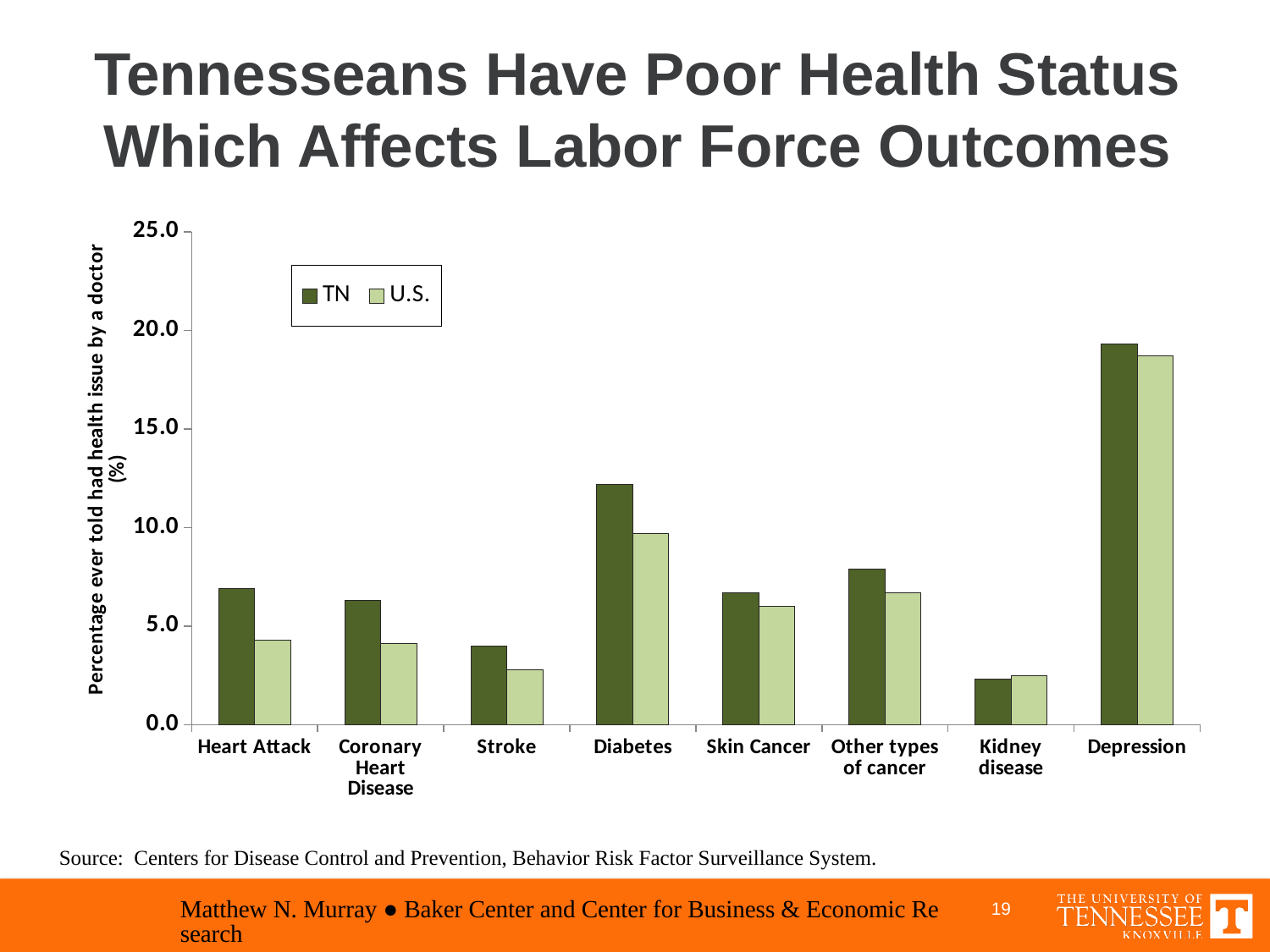
Is the U.S. value for Depression greater or less than 15.0? greater Is the TN value for Diabetes greater or less than 10.0? greater For Diabetes, which is larger, the TN value or the U.S. value? TN Is the U.S. value for Heart Attack greater or less than 5.0? less How many series does the legend list? 2 Which health condition has the highest TN value? Depression For Heart Attack, which is larger, the TN value or the U.S. value? TN Which health condition has the lowest TN value? Kidney disease What kind of chart is shown on the slide? bar chart How many health conditions are shown along the x axis? 8 What are the two entries in the chart's legend? TN and U.S.